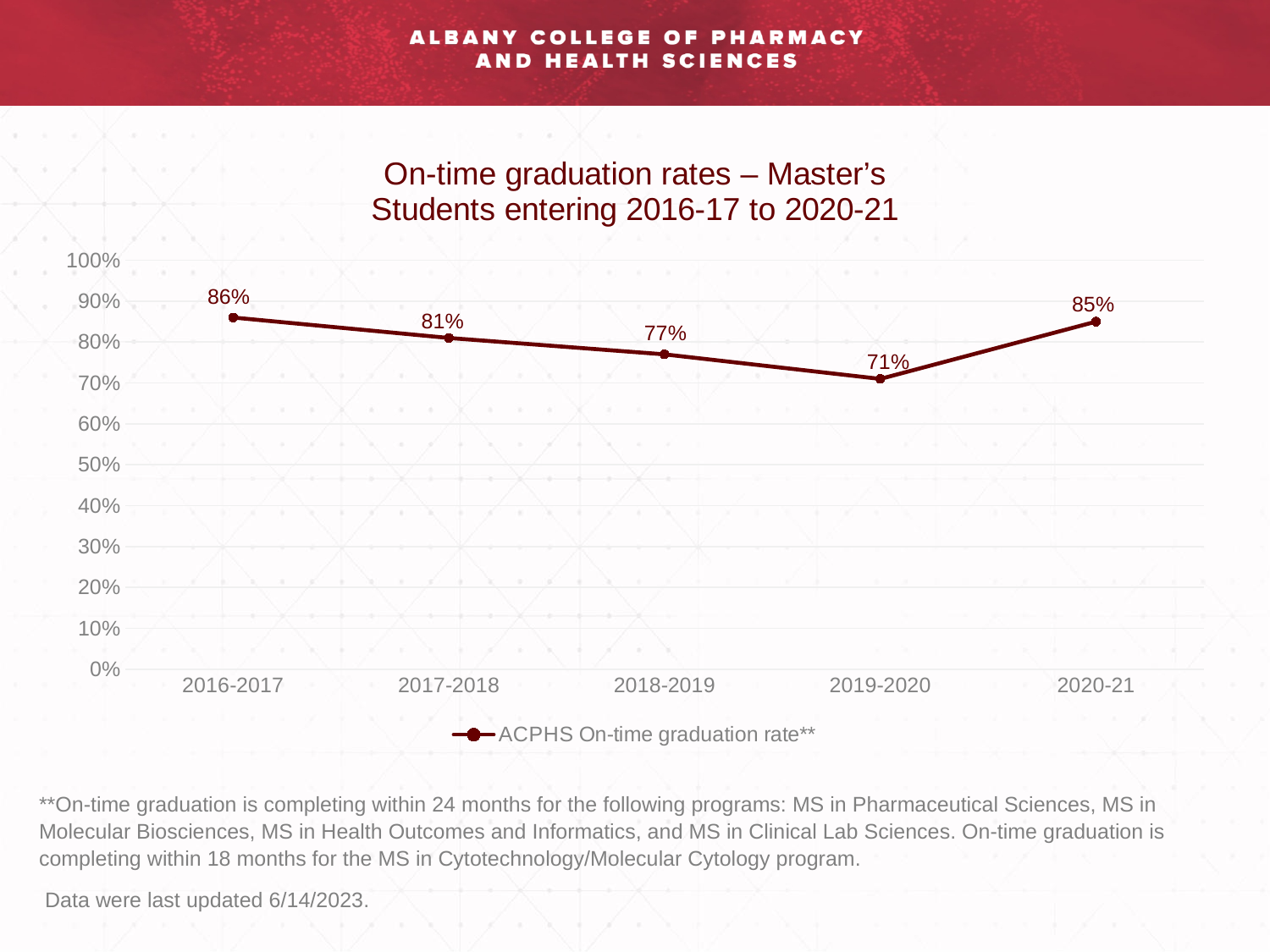
What is the on-time graduation rate for students entering in 2019-2020? 71% What is the on-time graduation rate for students entering in 2020-21? 85% Which entering cohort has the lowest on-time graduation rate? 2019-2020 What is the difference in on-time graduation rate between the 2016-2017 and 2019-2020 cohorts? 15% How many series does the legend list? 1 What is the on-time graduation rate for students entering in 2016-2017? 86% What kind of chart is shown on the slide? Line chart How many entering cohorts are plotted on the chart? 5 What is the name of the series shown in the legend? ACPHS On-time graduation rate** Which cohort has a higher on-time graduation rate, 2018-2019 or 2020-21? 2020-21 Which entering cohort has the highest on-time graduation rate? 2016-2017 What is the difference in on-time graduation rate between the 2017-2018 and 2018-2019 cohorts? 4%